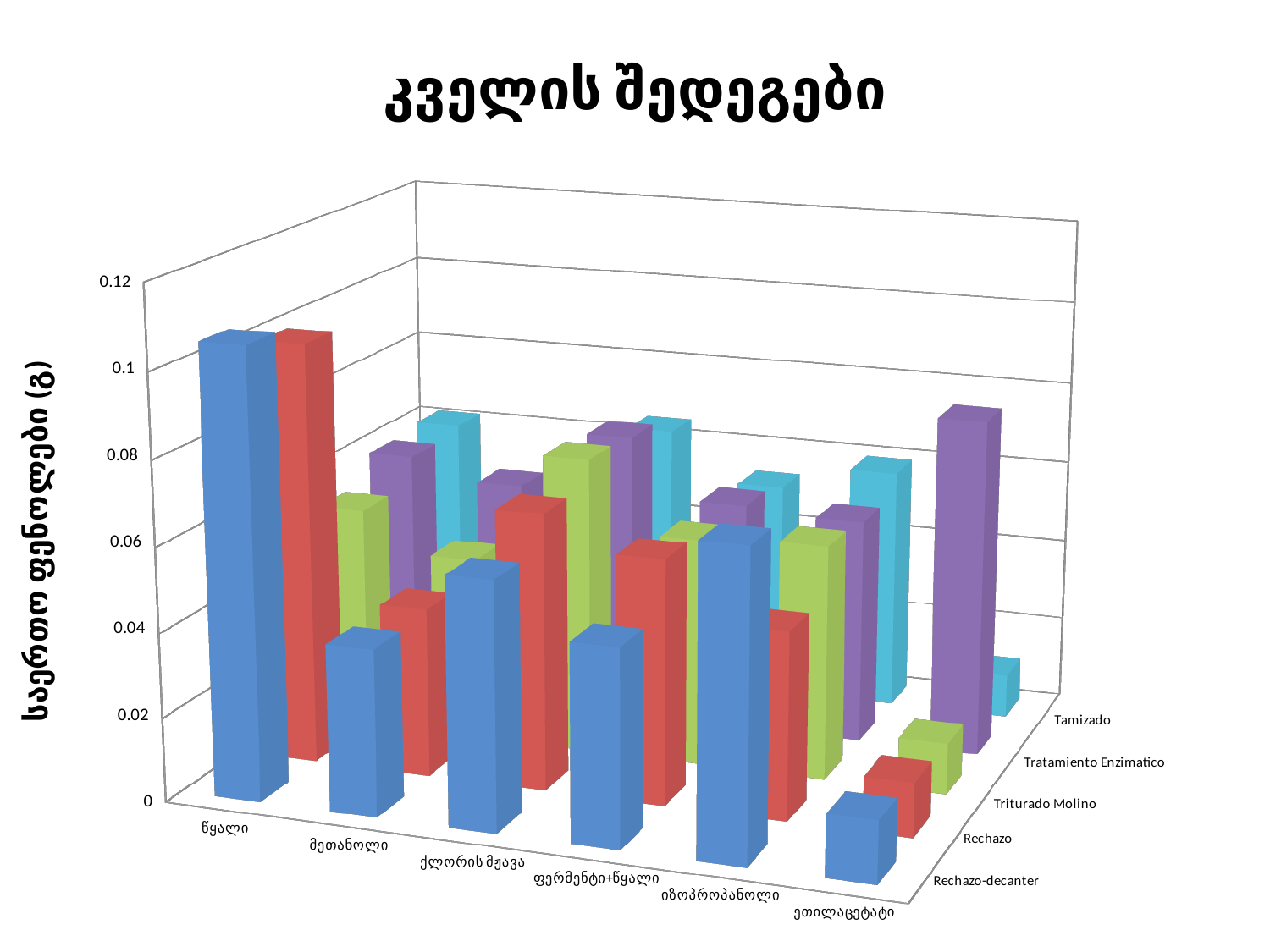
Is the Rechazo-decanter value for წყალი greater or less than 0.08? greater Which is larger for the Rechazo-decanter series: the value for წყალი or the value for მეთანოლი? წყალი What is the title of the chart? კვლის შედეგები Which is larger for the Rechazo-decanter series: the value for იზოპროპანოლი or the value for ეთილაცეტატი? იზოპროპანოლი What is the label of the vertical axis? საერთო ფენოლები (გ) How many series (depth-axis groups) does the chart show? 5 What kind of chart is shown on the slide? bar chart Which category has the lowest Rechazo-decanter value? ეთილაცეტატი Is the Rechazo-decanter value for მეთანოლი greater or less than 0.06? less Is the Tamizado value for ეთილაცეტატი greater or less than 0.04? less How many categories are shown along the x axis of the chart? 6